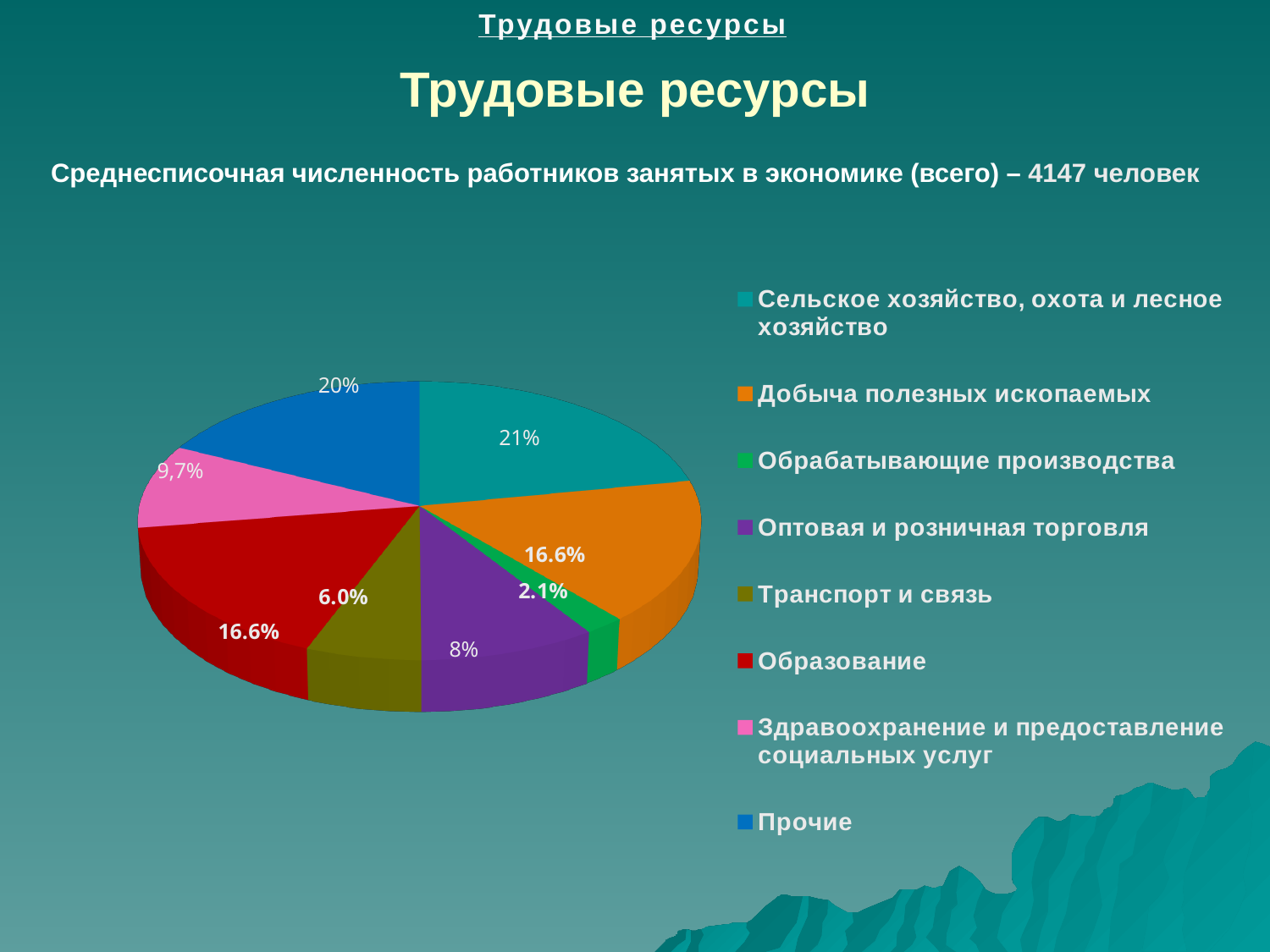
What share of the pie is labelled for Прочие? 20% What share of the pie is labelled for Оптовая и розничная торговля? 8% Which slice is larger: Оптовая и розничная торговля or Здравоохранение и предоставление социальных услуг? Здравоохранение и предоставление социальных услуг What share of the pie is labelled for Здравоохранение и предоставление социальных услуг? 9,7% What share of the pie is labelled for Сельское хозяйство, охота и лесное хозяйство? 21% Which category has the smallest slice of the pie? Обрабатывающие производства What share of the pie is labelled for Добыча полезных ископаемых? 16.6% What share of the pie is labelled for Обрабатывающие производства? 2.1% How many categories does the legend of the pie chart list? 8 According to the slide text, what is the total average number of workers employed in the economy? 4147 человек Which category has the largest slice of the pie? Сельское хозяйство, охота и лесное хозяйство What kind of chart is shown on the slide? pie chart